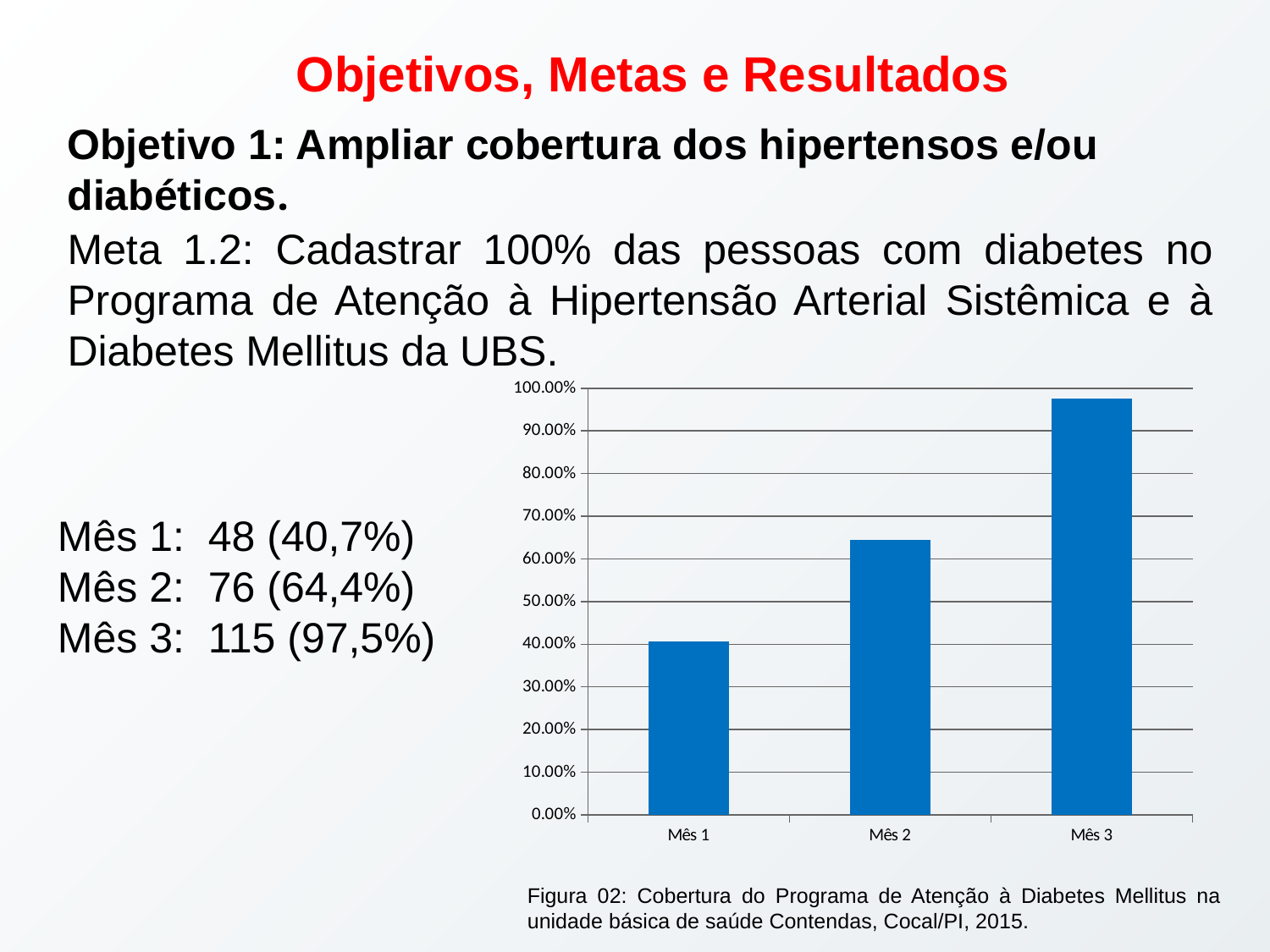
According to the slide, what coverage percentage does the bar for Mês 1 represent? 40,7% What kind of chart is shown on the slide? bar chart Is the value for Mês 2 greater or less than 60.00%? greater Is the value for Mês 1 greater or less than 50.00%? less How many categories (months) are plotted on the x axis of the chart? 3 Which is larger, the value for Mês 1 or the value for Mês 2? Mês 2 Do the values rise or fall from Mês 1 to Mês 3? rise Is the value for Mês 3 greater or less than 90.00%? greater Which month has the highest bar in the chart? Mês 3 What colour are the bars in the chart? blue Which month has the lowest bar in the chart? Mês 1 What is the figure number given in the caption below the chart? Figura 02